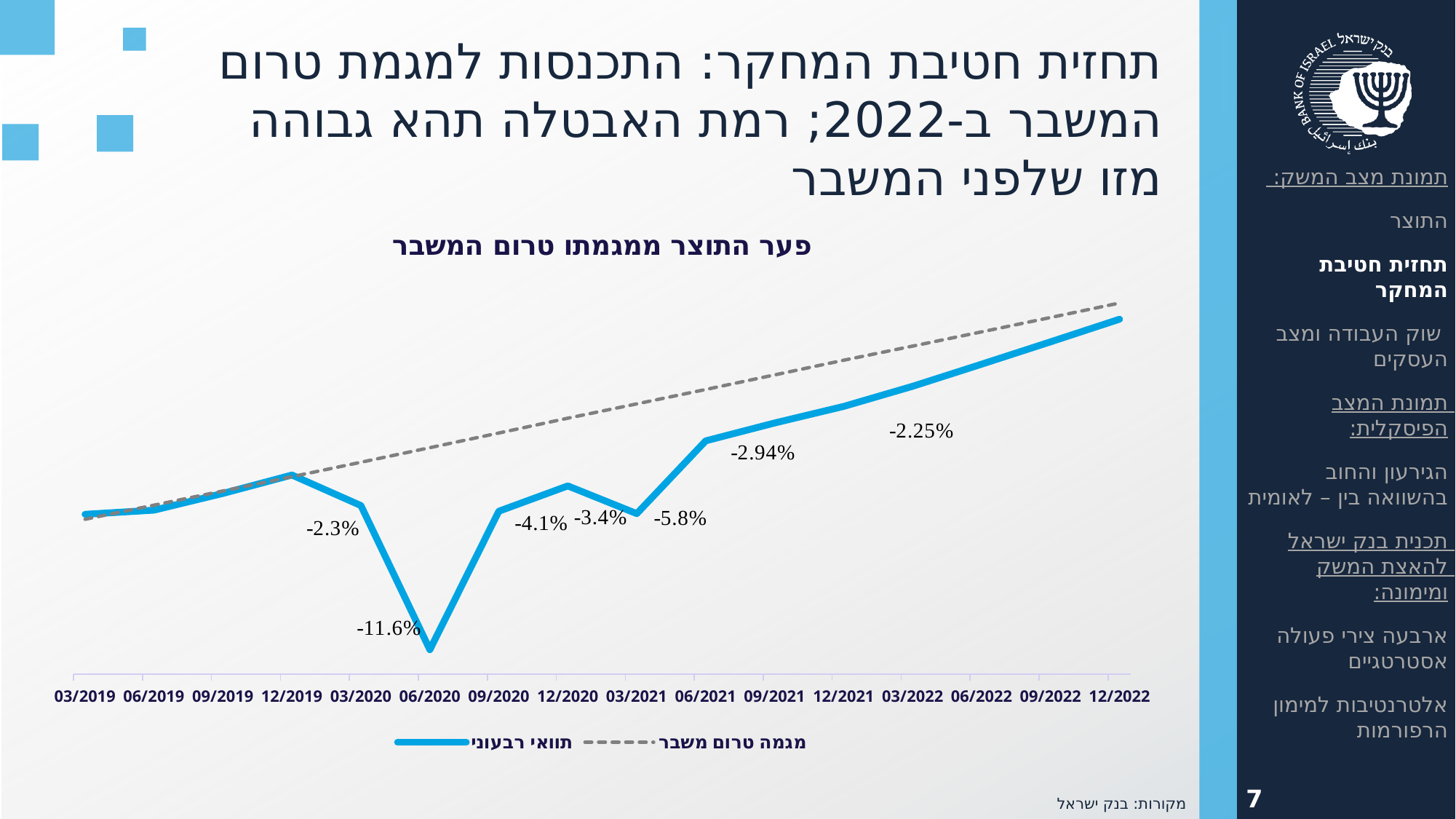
What is the data label shown for 03/2021 on the chart? -5.8% What is the title of the chart? פער התוצר ממגמתו טרום המשבר How many quarterly points are labeled along the x axis of the chart? 16 What kind of chart is shown on the slide? line chart Which quarter has the lowest labeled value on the chart? 06/2020 What is the data label shown for 09/2020 on the chart? -4.1% What is the difference between the labeled values for 06/2020 (-11.6%) and 09/2020 (-4.1%)? 7.5 percentage points What is the data label shown for 06/2020 on the chart? -11.6% Does the solid blue line rise or fall from 06/2020 to 12/2022? rise What is the data label shown for 03/2020 on the chart? -2.3% How many series does the chart legend list? 2 Which labeled value is lower, 03/2021 or 12/2020? 03/2021